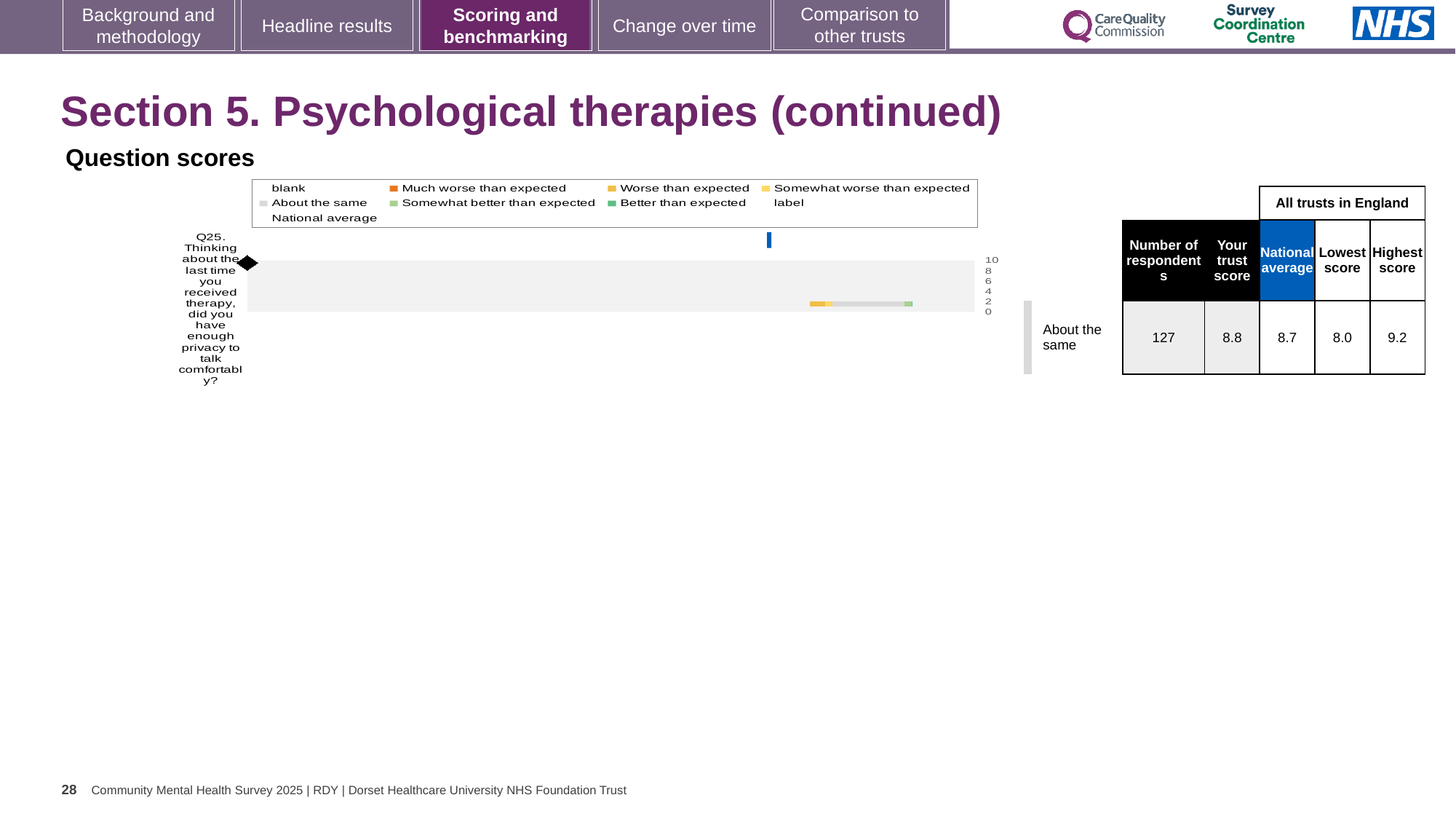
How many questions (categories) are plotted in the chart? 1 What kind of chart is shown under 'Question scores'? bar chart Which is larger for Q25, the trust score or the national average? the trust score What is the national average score for Q25? 8.7 What is the highest score among all trusts in England for Q25? 9.2 Which question number is plotted in the chart? Q25 How many entries does the chart legend list? 9 What is the trust score for Q25 shown next to the chart? 8.8 How many respondents answered Q25? 127 Which benchmark category is Q25 assigned to? About the same What is the difference between the highest and lowest scores for Q25? 1.2 What is the lowest score among all trusts in England for Q25? 8.0